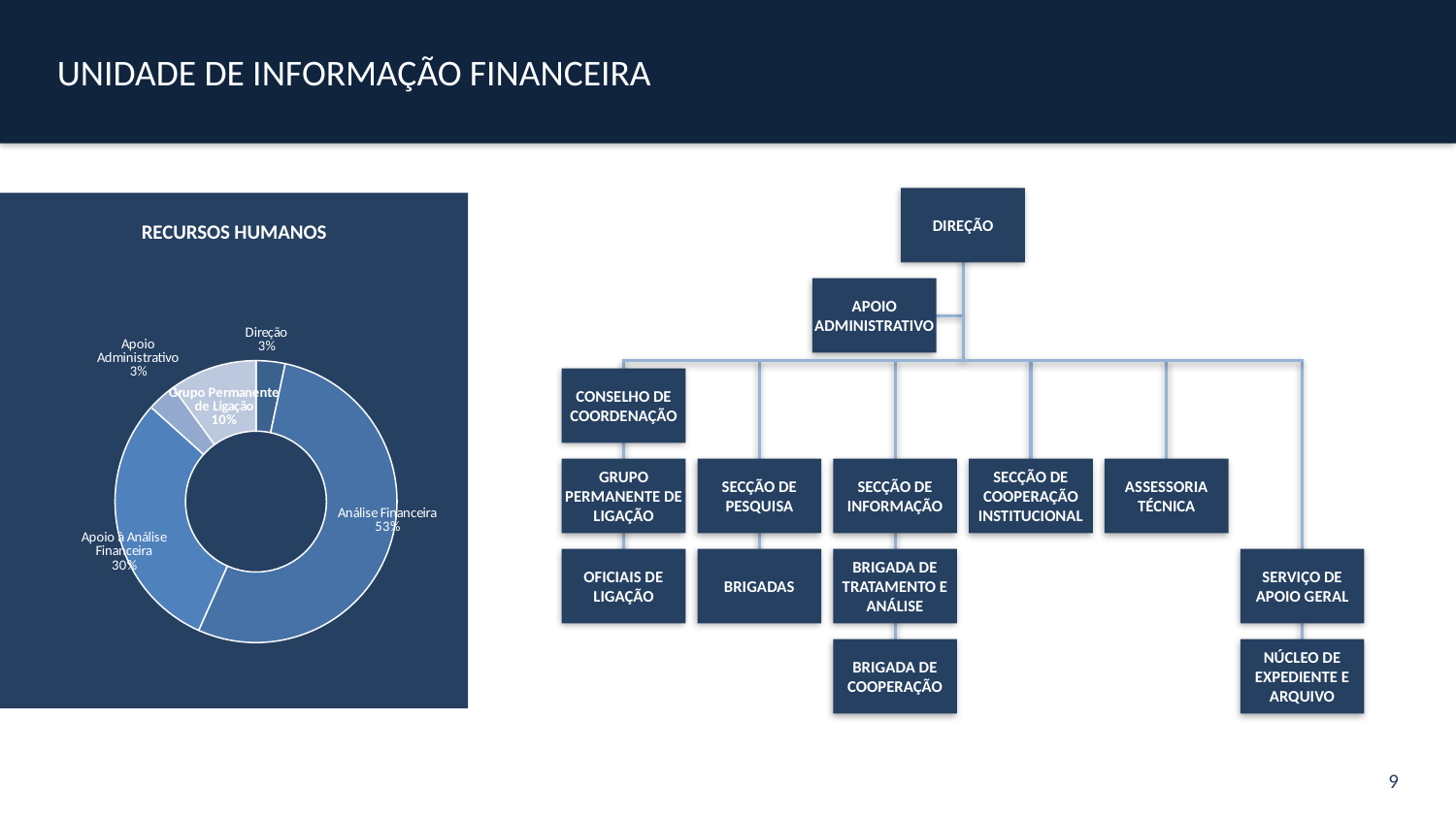
What share of the RECURSOS HUMANOS chart does Apoio Administrativo represent? 3% In the RECURSOS HUMANOS chart, what is the difference between the shares of Análise Financeira and Apoio à Análise Financeira? 23% What share of the RECURSOS HUMANOS chart does Análise Financeira represent? 53% Which category has the largest share in the RECURSOS HUMANOS chart? Análise Financeira What is the title of the chart on the left of the slide? RECURSOS HUMANOS In the RECURSOS HUMANOS chart, what is the combined share of Análise Financeira and Apoio à Análise Financeira? 83% In the RECURSOS HUMANOS chart, which is larger: Grupo Permanente de Ligação or Direção? Grupo Permanente de Ligação How many categories are shown in the RECURSOS HUMANOS chart? 5 What share of the RECURSOS HUMANOS chart does Direção represent? 3% What kind of chart is the RECURSOS HUMANOS chart? Doughnut chart What share of the RECURSOS HUMANOS chart does Grupo Permanente de Ligação represent? 10% What share of the RECURSOS HUMANOS chart does Apoio à Análise Financeira represent? 30%